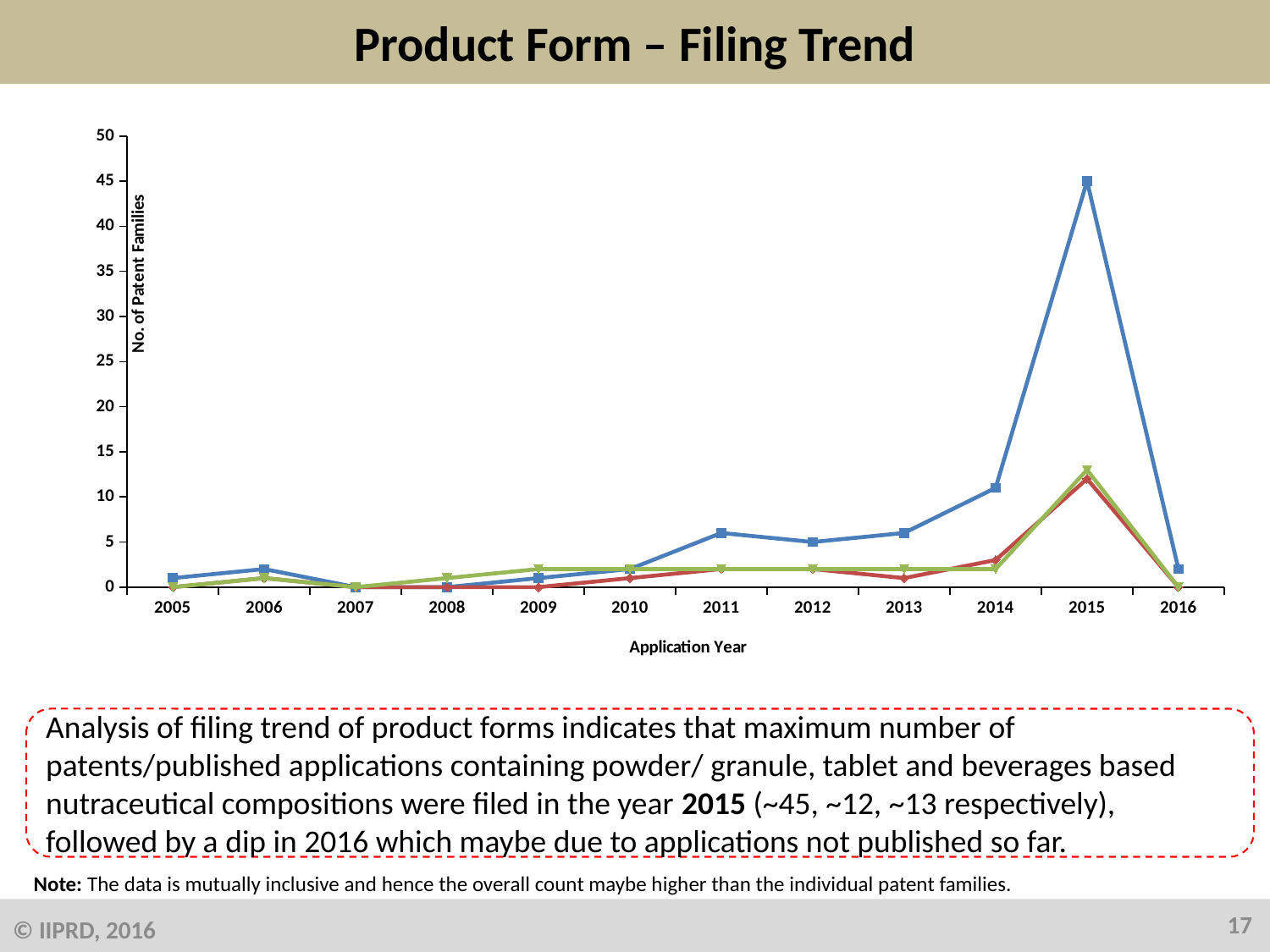
Do the values of all three lines rise or fall from 2015 to 2016? fall Is the value of the blue line in 2016 greater or less than 5? less Is the value of the blue line in 2014 greater or less than 15? less What is the title of the chart on the slide? Product Form – Filing Trend What is the label of the vertical axis? No. of Patent Families In which application year does the blue line reach its highest value? 2015 In 2015, which line has the larger value, the blue line or the green line? blue line Do the values of the blue line rise or fall from 2013 to 2015? rise What type of chart is shown on the slide? line chart Is the value of the blue line in 2015 greater or less than 40? greater What value do all three lines show in 2007? 0 How many application years are plotted along the x axis? 12